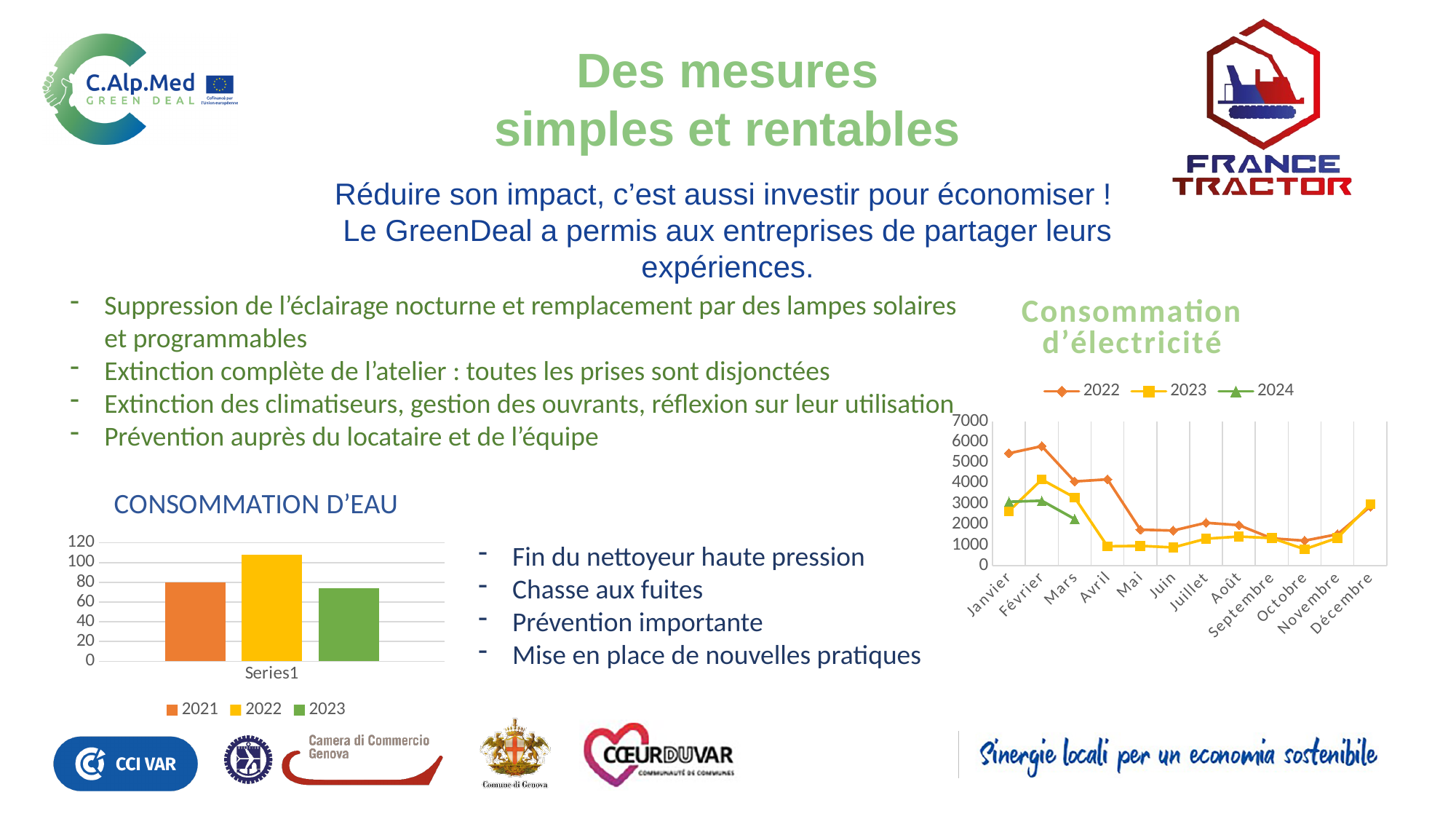
In the 'CONSOMMATION D'EAU' chart, is the value for 2022 greater or less than 100? greater How many series does the legend of the 'CONSOMMATION D'EAU' chart list? 3 In the 'Consommation d'électricité' chart, does the 2022 series rise or fall from Février to Mai? fall In the 'Consommation d'électricité' chart, is the 2022 value for Février greater or less than 5000? greater How many months are shown on the x axis of the 'Consommation d'électricité' chart? 12 How many series does the legend of the 'Consommation d'électricité' chart list? 3 In the 'CONSOMMATION D'EAU' chart, which year has the highest bar? 2022 In the 'CONSOMMATION D'EAU' chart, which year has the lowest bar? 2023 What kind of chart is the 'Consommation d'électricité' chart? line chart What kind of chart is the 'CONSOMMATION D'EAU' chart? bar chart In the 'CONSOMMATION D'EAU' chart, which is larger, the bar for 2021 or the bar for 2022? 2022 In the 'Consommation d'électricité' chart, which series is higher in Janvier, 2022 or 2023? 2022